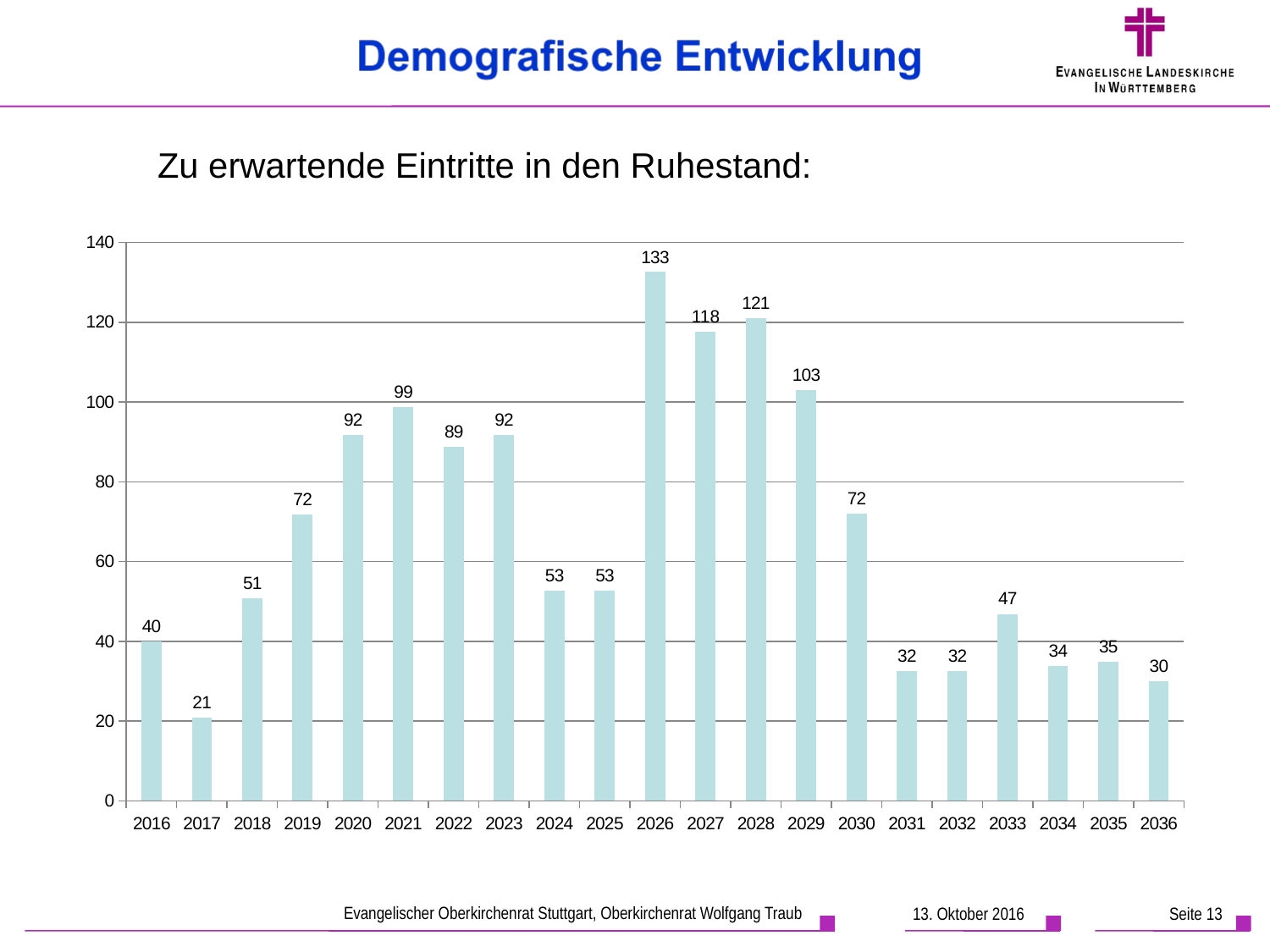
What is the subtitle text above the chart? Zu erwartende Eintritte in den Ruhestand: What is the value for 2029? 103 What is the difference between the values for 2028 and 2027? 3 Which year has the lowest value in the chart? 2017 What is the difference between the values for 2026 and 2036? 103 What is the expected number of retirements in 2026? 133 Do the values rise or fall from 2030 to 2032? fall Which year has the highest expected number of retirements? 2026 What kind of chart is shown on the slide? bar chart What value is shown for 2017? 21 How many years are shown on the x axis? 21 Which is larger, the value for 2021 or the value for 2022? 2021